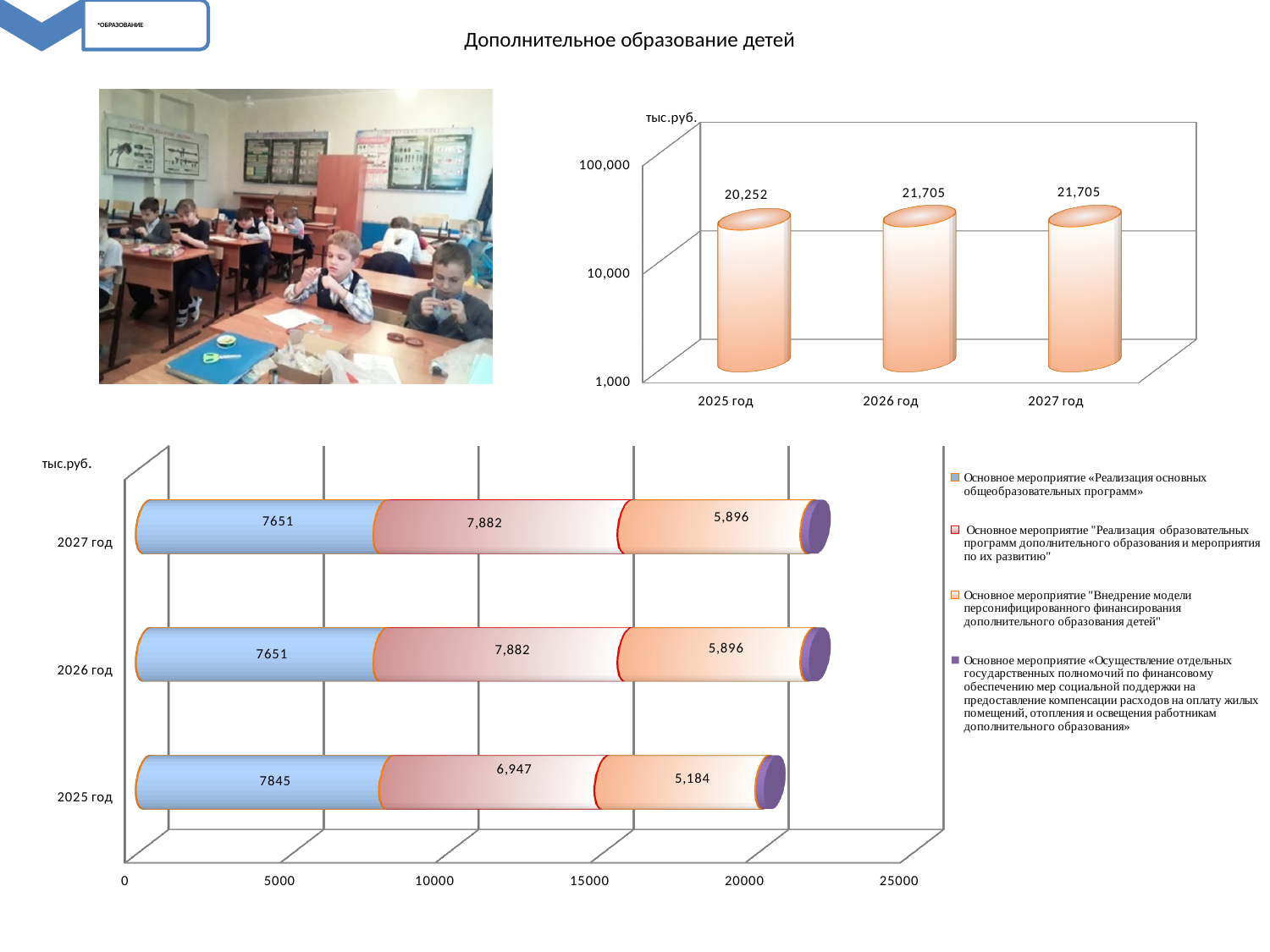
In the top-right chart, how many years are shown on the x axis? 3 In the top-right chart, which year has the lowest value? 2025 год In the top-right chart, what is the value for 2025 год? 20,252 In the bottom chart, how many series does the legend list? 4 In the top-right chart, what unit is shown above the vertical axis? тыс.руб. In the bottom chart, what is the difference between the orange segment values for 2027 год and 2025 год? 712 In the top-right chart, what is the difference between the values for 2026 год and 2025 год? 1,453 In the bottom chart, what is the value of the orange segment (Внедрение модели персонифицированного финансирования) for 2025 год? 5,184 In the bottom chart, what is the value of the red segment (Реализация образовательных программ дополнительного образования) for 2026 год? 7,882 In the bottom chart, which is larger for 2025 год: the blue segment or the red segment? the blue segment (7845) In the bottom chart, what is the value of the blue segment (Реализация основных общеобразовательных программ) for 2025 год? 7845 In the top-right chart, what is the value for 2027 год? 21,705